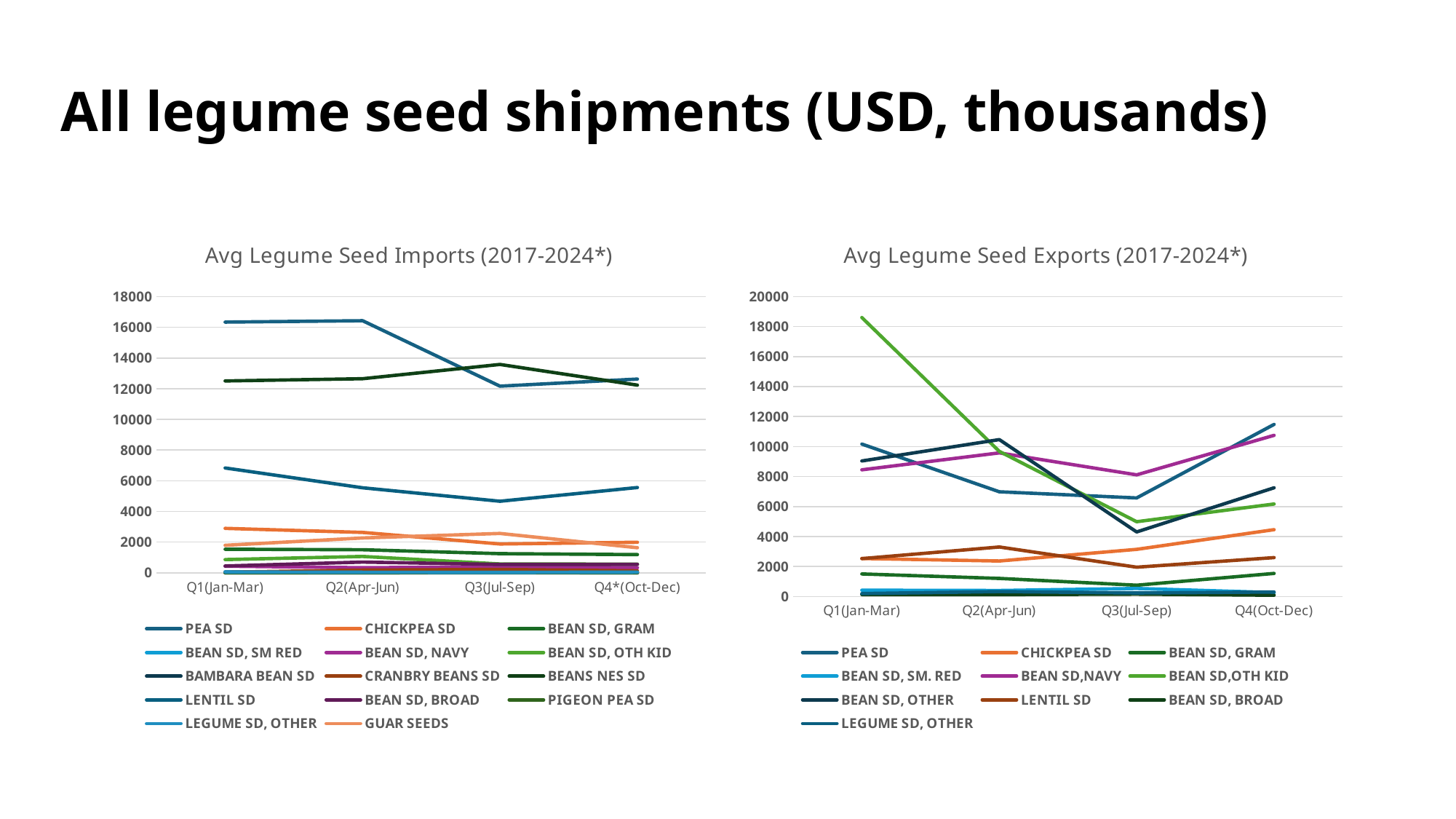
In the 'Avg Legume Seed Exports (2017-2024*)' chart, is the value for CHICKPEA SD at Q4(Oct-Dec) greater or less than 4000? greater What kind of chart is the 'Avg Legume Seed Imports (2017-2024*)' chart? Line chart What is the highest value shown on the y axis of the 'Avg Legume Seed Exports (2017-2024*)' chart? 20000 In the 'Avg Legume Seed Exports (2017-2024*)' chart, does the BEAN SD,OTH KID line rise or fall from Q1(Jan-Mar) to Q3(Jul-Sep)? fall In the 'Avg Legume Seed Exports (2017-2024*)' chart, is the value for BEAN SD,OTH KID at Q1(Jan-Mar) greater or less than 16000? greater In the 'Avg Legume Seed Imports (2017-2024*)' chart, is the value for PEA SD at Q1(Jan-Mar) greater or less than 14000? greater How many quarters are shown on the x axis of the 'Avg Legume Seed Exports (2017-2024*)' chart? 4 How many series does the legend of the 'Avg Legume Seed Imports (2017-2024*)' chart list? 14 How many charts are shown on the slide? 2 In the 'Avg Legume Seed Exports (2017-2024*)' chart, which series has the highest value at Q1(Jan-Mar)? BEAN SD,OTH KID How many series does the legend of the 'Avg Legume Seed Exports (2017-2024*)' chart list? 10